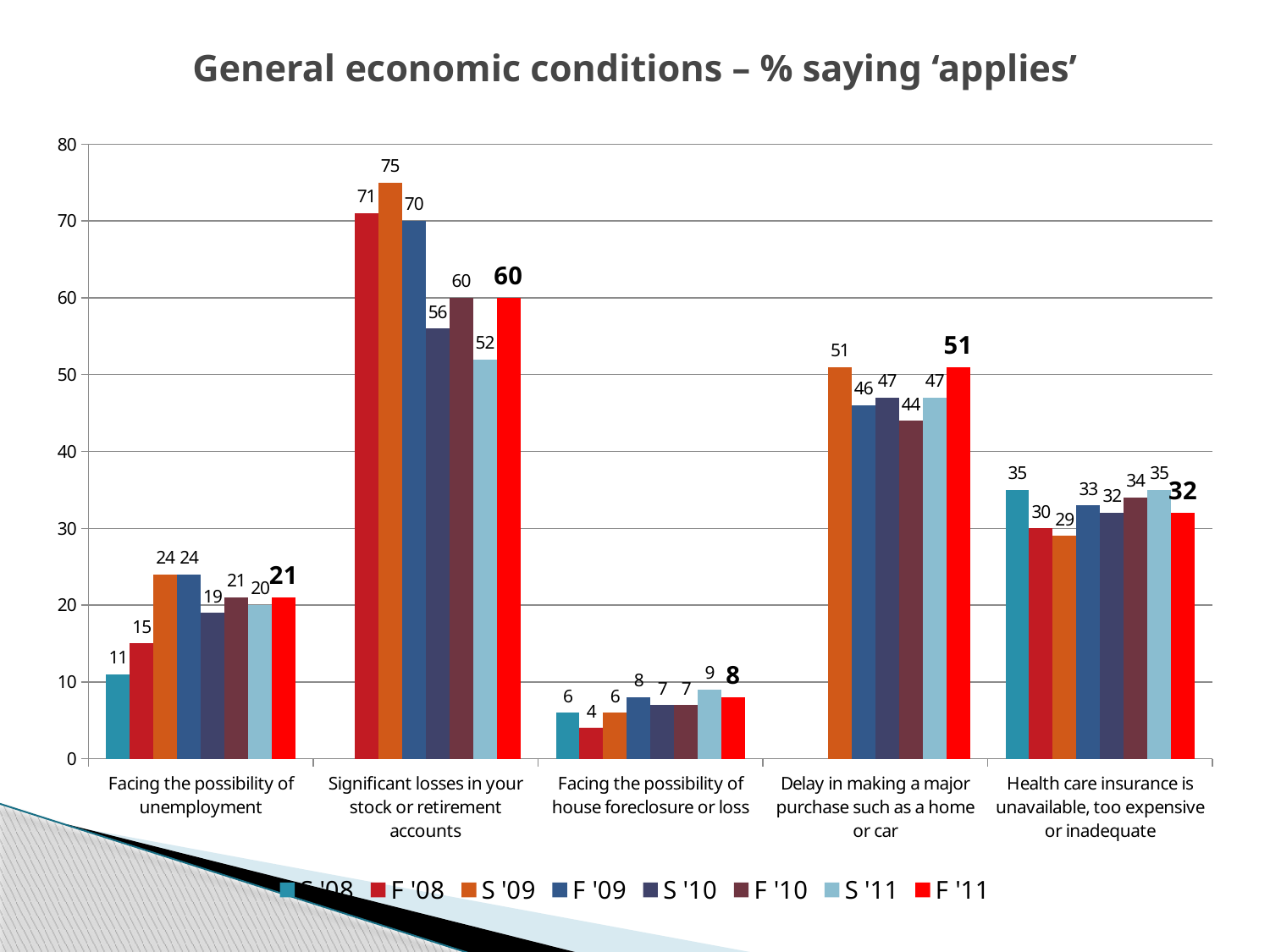
How many categories are shown on the x axis? 5 Which category has the highest value on the chart? Significant losses in your stock or retirement accounts What is the difference between the F '11 and S '08 values for 'Facing the possibility of unemployment'? 10 What is the value for F '11 in the 'Health care insurance is unavailable, too expensive or inadequate' category? 32 What is the highest value shown in the 'Significant losses in your stock or retirement accounts' category? 75 What kind of chart is shown on the slide? bar chart What is the lowest value shown in the 'Facing the possibility of house foreclosure or loss' category? 4 In the 'Health care insurance is unavailable, too expensive or inadequate' category, which is larger: S '08 or F '11? S '08 Is the value for F '10 in 'Delay in making a major purchase such as a home or car' greater or less than 50? less What is the value for S '09 in the 'Delay in making a major purchase such as a home or car' category? 51 What is the value for F '11 in the 'Significant losses in your stock or retirement accounts' category? 60 How many series does the legend list? 8